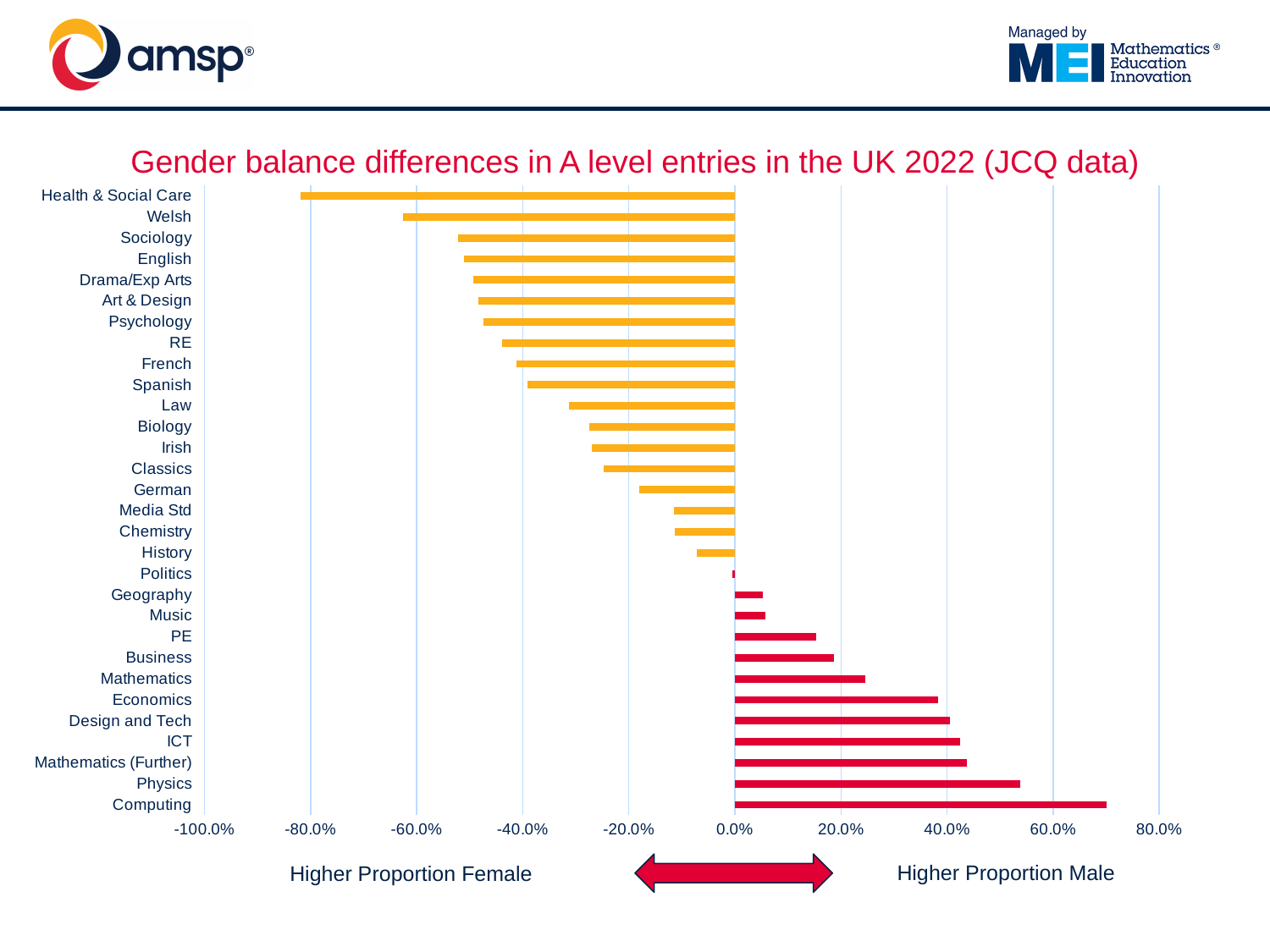
Which has the larger value, Physics or Mathematics (Further)? Physics Is the value for Computing greater or less than 60.0%? greater Which subject has the highest value in the chart? Computing What is the title of the chart? Gender balance differences in A level entries in the UK 2022 (JCQ data) Is the value for Physics greater or less than 40.0%? greater Which has the larger value, Mathematics or Business? Mathematics Is the value for Health & Social Care greater or less than -80.0%? less Which subject has the lowest value in the chart? Health & Social Care What type of chart is shown on the slide? bar chart How many subjects (categories) are plotted in the chart? 30